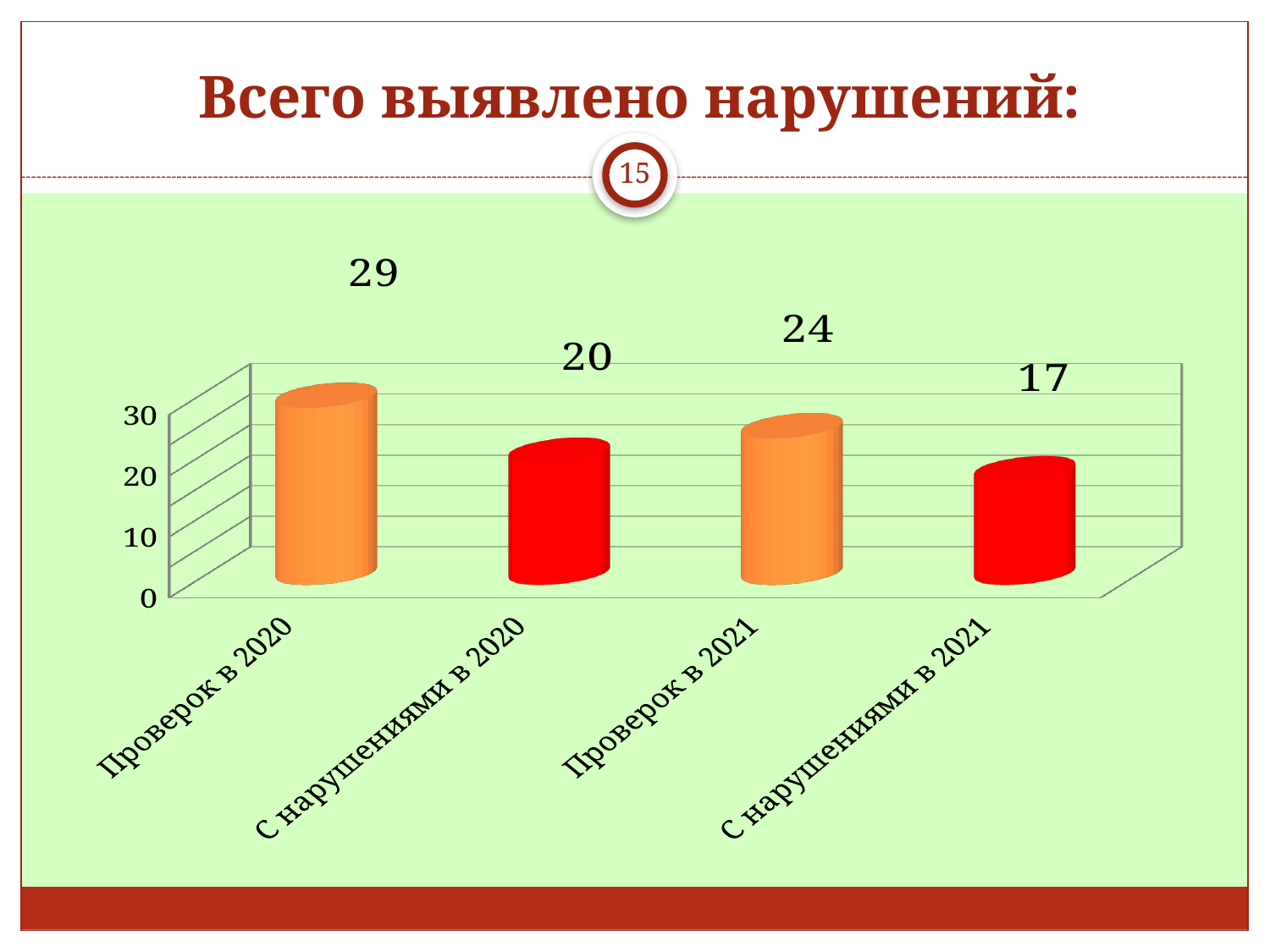
How many categories are shown on the chart? 4 What is the value for "С нарушениями в 2020"? 20 What is the value for "С нарушениями в 2021"? 17 What is the difference between the values for "С нарушениями в 2020" and "С нарушениями в 2021"? 3 Which is larger, the value for "С нарушениями в 2020" or the value for "Проверок в 2021"? Проверок в 2021 What is the value for "Проверок в 2021"? 24 What is the value for "Проверок в 2020"? 29 Which category has the highest value? Проверок в 2020 What is the title of the slide above the chart? Всего выявлено нарушений: Which category has the lowest value? С нарушениями в 2021 What kind of chart is shown on the slide? Bar chart What is the difference between the values for "Проверок в 2020" and "Проверок в 2021"? 5